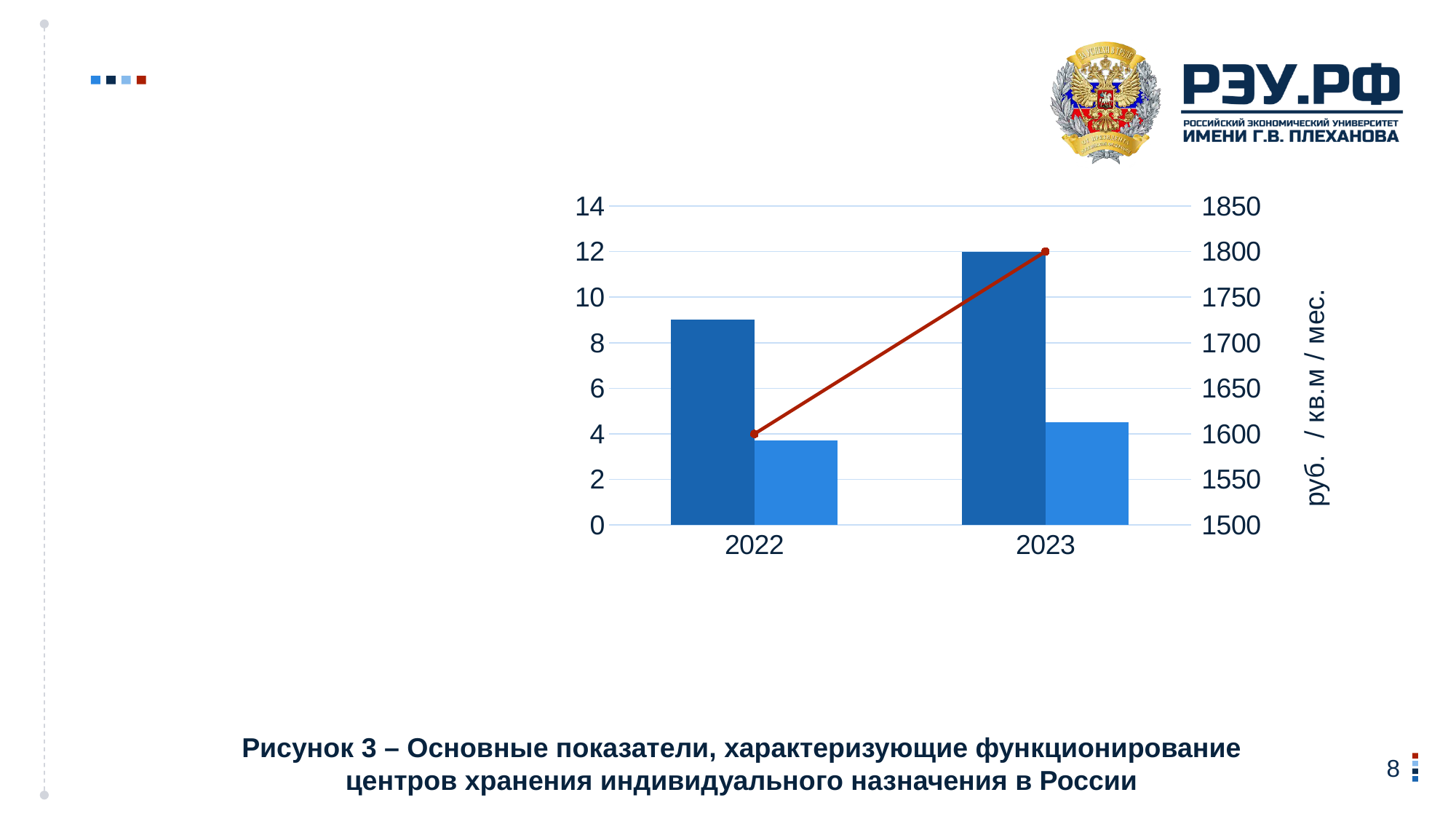
Is the value of the light blue bar for 2023 greater or less than 4? greater What is the value of the red line for 2023 on the right axis? 1800 Does the red line rise or fall from 2022 to 2023? rise By how much does the red line value increase from 2022 to 2023? 200 How many years are shown on the x axis of the chart? 2 What kind of chart is shown on the slide? bar chart with a line What is the label of the right-hand vertical axis? руб. / кв.м / мес. Is the value of the light blue bar for 2022 greater or less than 4? less Is the value of the dark blue bar for 2022 greater or less than 8? greater What is the value of the red line for 2022 on the right axis? 1600 What is the value of the dark blue bar for 2023 on the left axis? 12 Which year has the taller dark blue bar, 2022 or 2023? 2023